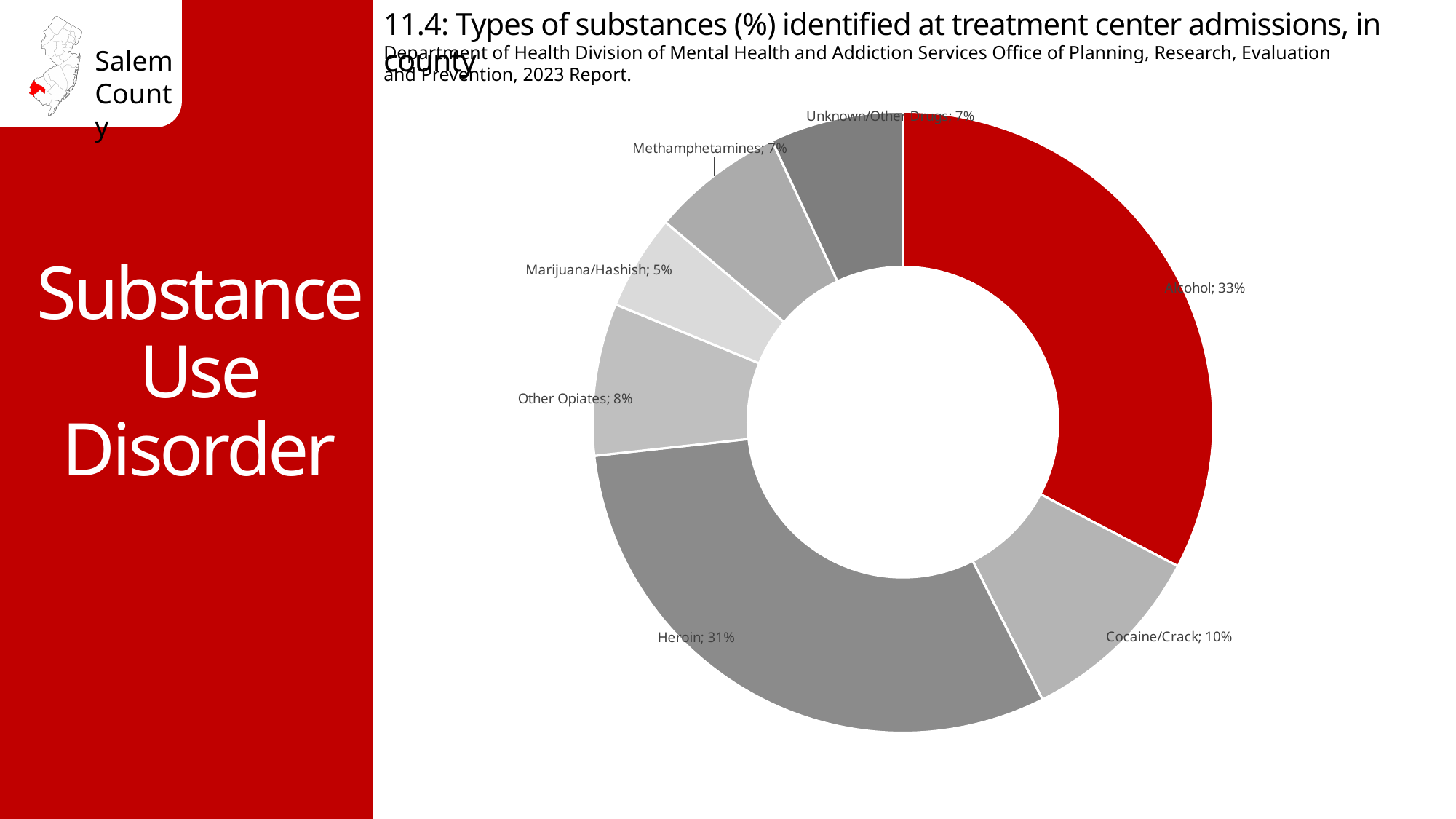
How many percentage points higher is Alcohol than Heroin? 2% Which substance has the largest share of admissions? Alcohol What is the difference between the Heroin share and the Other Opiates share? 23% What kind of chart is used on this slide? doughnut (pie) chart What is the value for Cocaine/Crack? 10% What is the value for Methamphetamines? 7% How many substance categories are shown in the chart? 7 What percentage of treatment center admissions is identified as Alcohol? 33% What percentage is shown for Other Opiates? 8% What percentage is shown for Heroin? 31% Which is larger, the share for Cocaine/Crack or the share for Other Opiates? Cocaine/Crack Which substance has the smallest share of admissions? Marijuana/Hashish